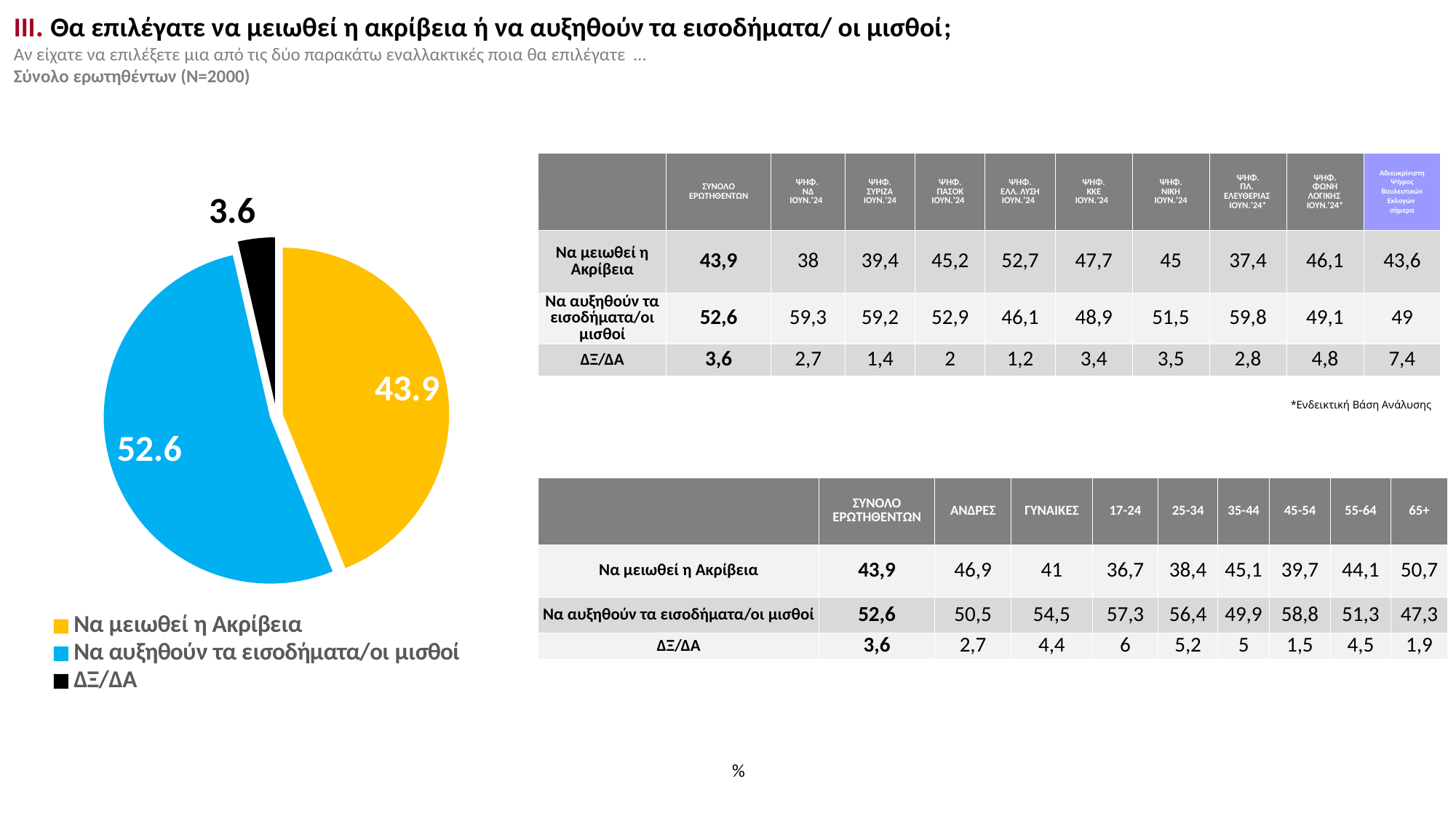
What colour is the slice for "Να μειωθεί η Ακρίβεια" in the pie chart? Yellow Which category has the largest slice in the pie chart? Να αυξηθούν τα εισοδήματα/οι μισθοί Which category has the smallest slice in the pie chart? ΔΞ/ΔΑ In the pie chart, which is larger: "Να μειωθεί η Ακρίβεια" or "Να αυξηθούν τα εισοδήματα/οι μισθοί"? Να αυξηθούν τα εισοδήματα/οι μισθοί What value does the pie chart show for "Να μειωθεί η Ακρίβεια"? 43.9 What is the difference between the values for "Να μειωθεί η Ακρίβεια" and "ΔΞ/ΔΑ" in the pie chart? 40.3 What is the difference between the values for "Να αυξηθούν τα εισοδήματα/οι μισθοί" and "Να μειωθεί η Ακρίβεια" in the pie chart? 8.7 How many slices does the pie chart have? 3 What value does the pie chart show for "Να αυξηθούν τα εισοδήματα/οι μισθοί"? 52.6 What colour is the slice for "ΔΞ/ΔΑ" in the pie chart? Black What type of chart is shown on the left of the slide? Pie chart What value does the pie chart show for "ΔΞ/ΔΑ"? 3.6